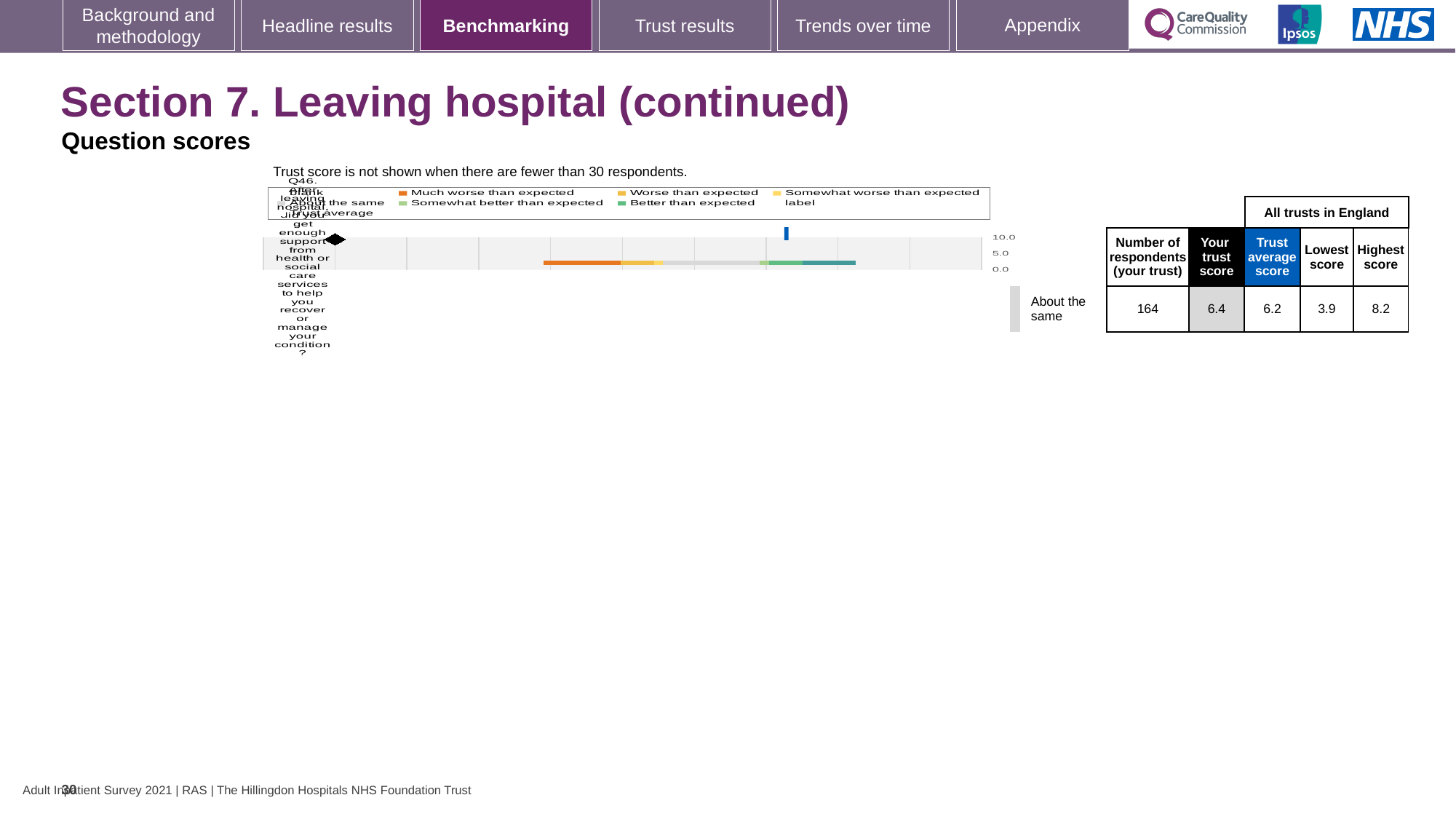
What is the lowest score among all trusts in England for Q46? 3.9 What is the highest value shown on the chart's axis? 10.0 What is the trust's score for Q46 shown alongside the chart? 6.4 Is the trust's score for Q46 greater or less than 5.0 on the chart axis? greater What is the trust average score for Q46 across all trusts in England? 6.2 What is the difference between the highest score and the lowest score among all trusts in England for Q46? 4.3 Which is larger for Q46: the trust's score or the trust average score? the trust's score How many respondents from the trust answered Q46? 164 What is the highest score among all trusts in England for Q46? 8.2 What kind of chart is used to show the expected-range benchmarking for Q46? bar chart What is the difference between the trust's score and the trust average score for Q46? 0.2 Which legend entry is shown in orange on the chart? Much worse than expected